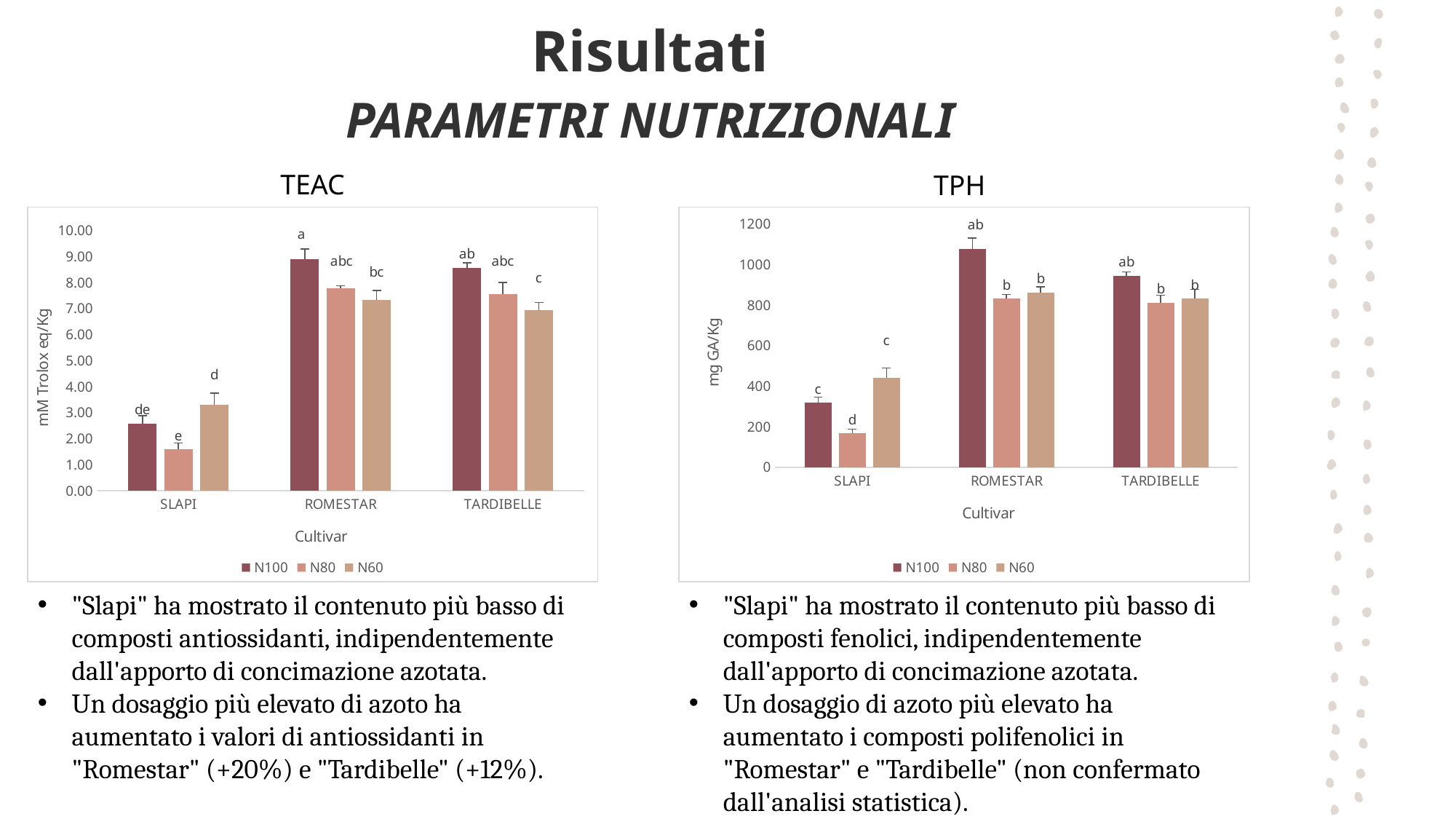
In the TEAC chart, is the value for ROMESTAR N100 greater or less than 8.00? greater In the TEAC chart, is the value for SLAPI N80 greater or less than 2.00? less In the TPH chart, is the value for ROMESTAR N100 greater or less than 1000? greater In the TEAC chart, which series has the lowest bar for SLAPI? N80 What is the y-axis label of the TEAC chart? mM Trolox eq/Kg How many series does the legend of the TEAC chart list? 3 In the TPH chart, which cultivar and series has the highest bar? ROMESTAR N100 In the TPH chart, which is larger for SLAPI: N60 or N100? N60 What is the y-axis label of the TPH chart? mg GA/Kg How many cultivars are shown on the x axis of the TPH chart? 3 What kind of chart is the TEAC chart? bar chart In the TPH chart, which cultivar and series has the lowest bar? SLAPI N80